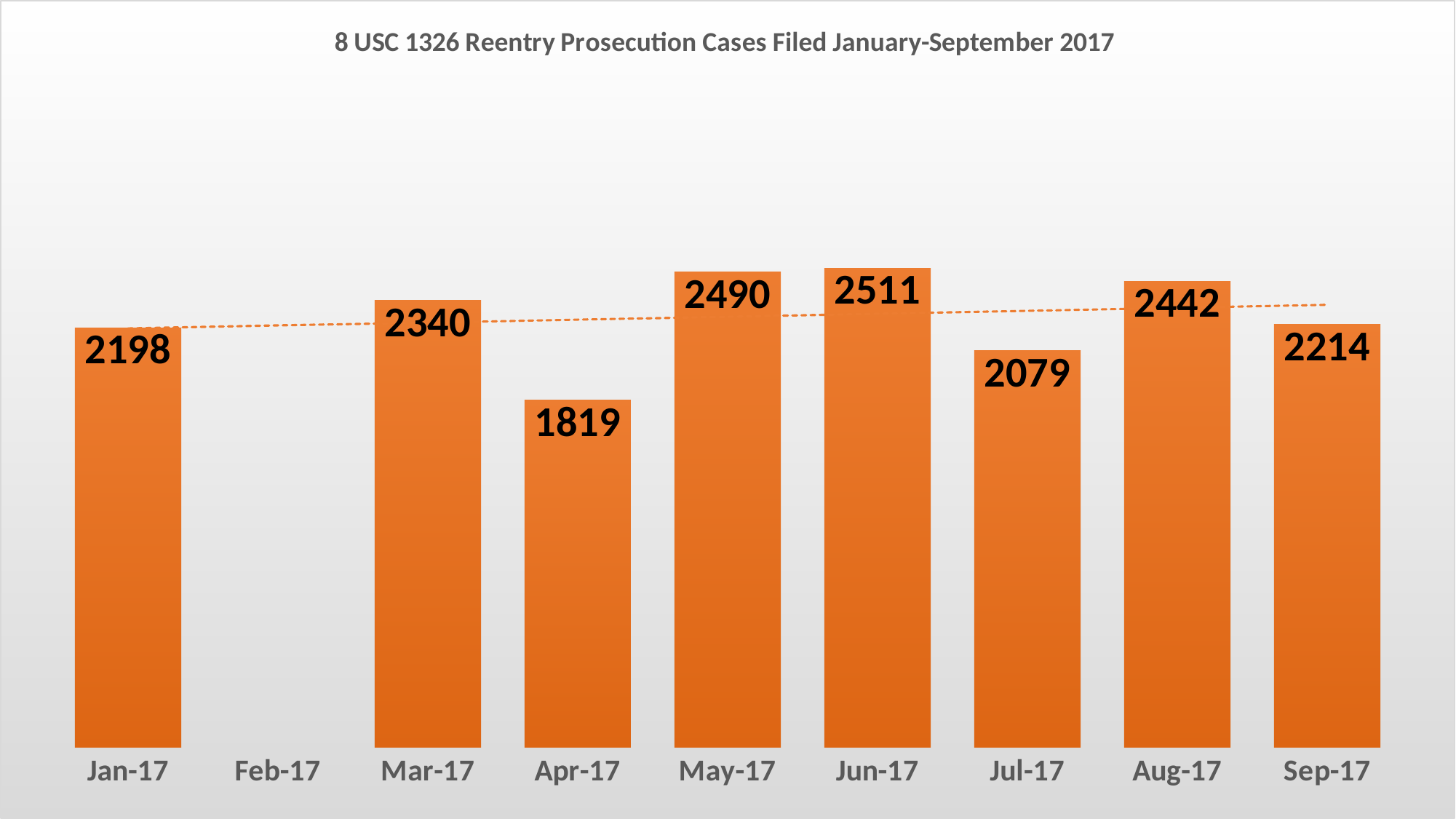
How many months are labelled on the x axis? 9 What is the difference between the values for Mar-17 and Apr-17? 521 What kind of chart is shown on the slide? bar chart What is the value shown for Apr-17? 1819 What is the difference between the values for Jun-17 and Jul-17? 432 Which month has the highest number of cases filed? Jun-17 How many cases were filed in Jan-17? 2198 Which month has the lowest number of cases filed? Apr-17 What is the title of the chart? 8 USC 1326 Reentry Prosecution Cases Filed January-September 2017 Which is larger, the value for Sep-17 or the value for Jan-17? Sep-17 Which month on the x axis has no bar plotted? Feb-17 What is the value shown for Aug-17? 2442